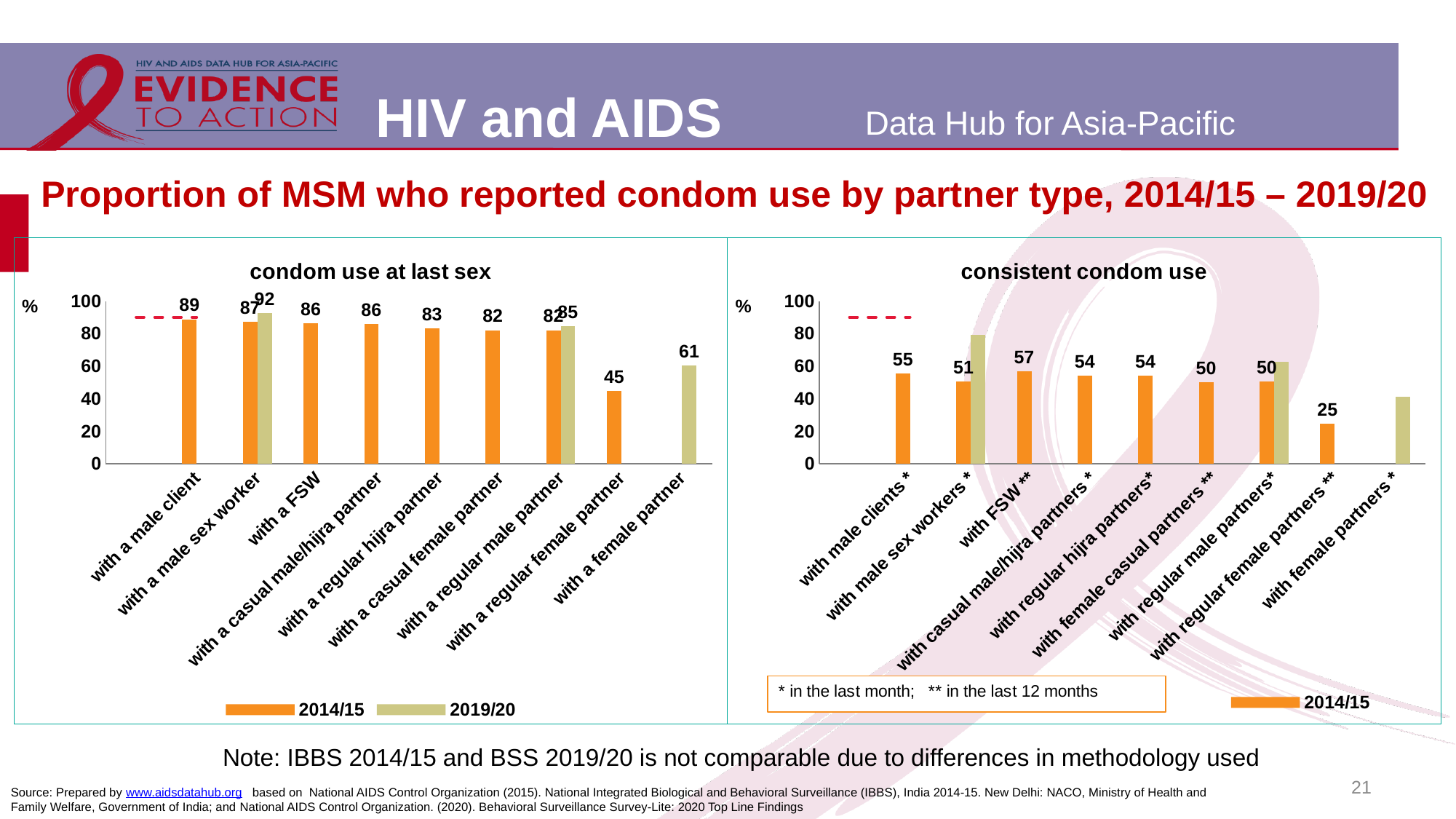
In the 'consistent condom use' chart, what is the difference between the 2014/15 values for 'with male clients *' and 'with regular female partners **'? 30 How many series does the legend of the 'condom use at last sex' chart list? 2 In the 'condom use at last sex' chart, which partner type has the lowest 2014/15 value? with a regular female partner In the 'condom use at last sex' chart, what is the difference between the 2019/20 and 2014/15 values for 'with a male sex worker'? 5 How many partner-type categories are shown on the x axis of the 'condom use at last sex' chart? 9 In the 'condom use at last sex' chart, what is the 2014/15 value for 'with a male client'? 89 In the 'consistent condom use' chart, is the unlabelled bar for 'with female partners *' greater or less than 60? less In the 'consistent condom use' chart, which has the higher 2014/15 value: 'with male clients *' or 'with male sex workers *'? with male clients * In the 'consistent condom use' chart, what is the 2014/15 value for 'with FSW **'? 57 In the 'condom use at last sex' chart, what is the 2019/20 value for 'with a male sex worker'? 92 What type of chart is the 'condom use at last sex' chart? bar chart In the 'consistent condom use' chart, which partner type has the lowest labelled 2014/15 value? with regular female partners **